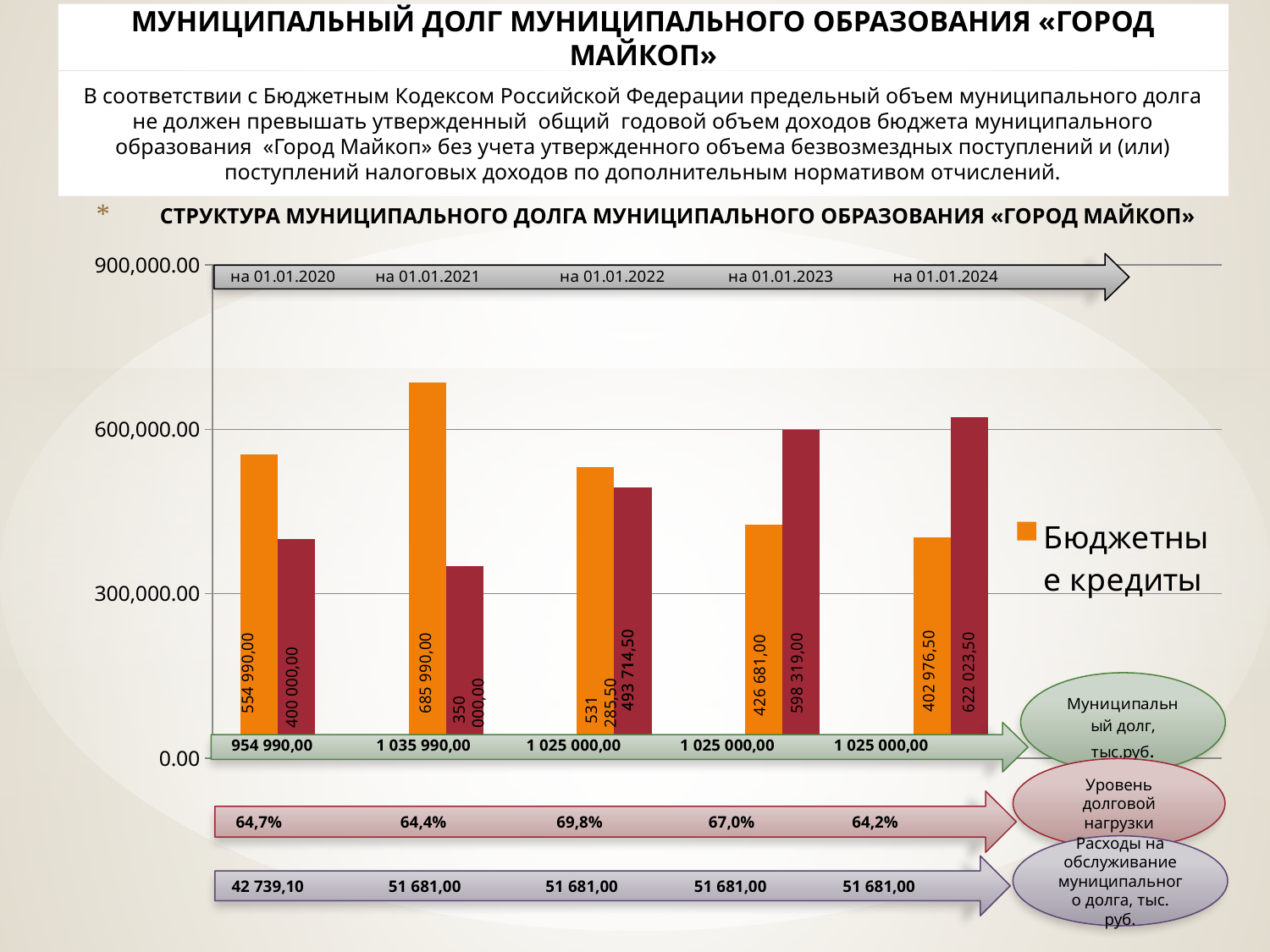
What is the value of Бюджетные кредиты на 01.01.2024? 402 976,50 What kind of chart is used to show the structure of municipal debt? bar chart How many dates (categories) are shown on the x axis of the chart? 5 What is the total municipal debt (Муниципальный долг, тыс.руб.) shown for на 01.01.2021? 1 035 990,00 On which date is the value of Бюджетные кредиты the highest? на 01.01.2021 What series name is shown in the chart legend? Бюджетные кредиты Do the values of Бюджетные кредиты rise or fall from на 01.01.2021 to на 01.01.2024? fall Is the value of Бюджетные кредиты на 01.01.2021 greater or less than 600,000.00? greater On which date is the value of Бюджетные кредиты the lowest? на 01.01.2024 What is the value of Бюджетные кредиты на 01.01.2020? 554 990,00 By how much does Бюджетные кредиты на 01.01.2021 exceed the value на 01.01.2020? 131 000,00 Which is larger for Бюджетные кредиты: the value на 01.01.2022 or на 01.01.2023? на 01.01.2022